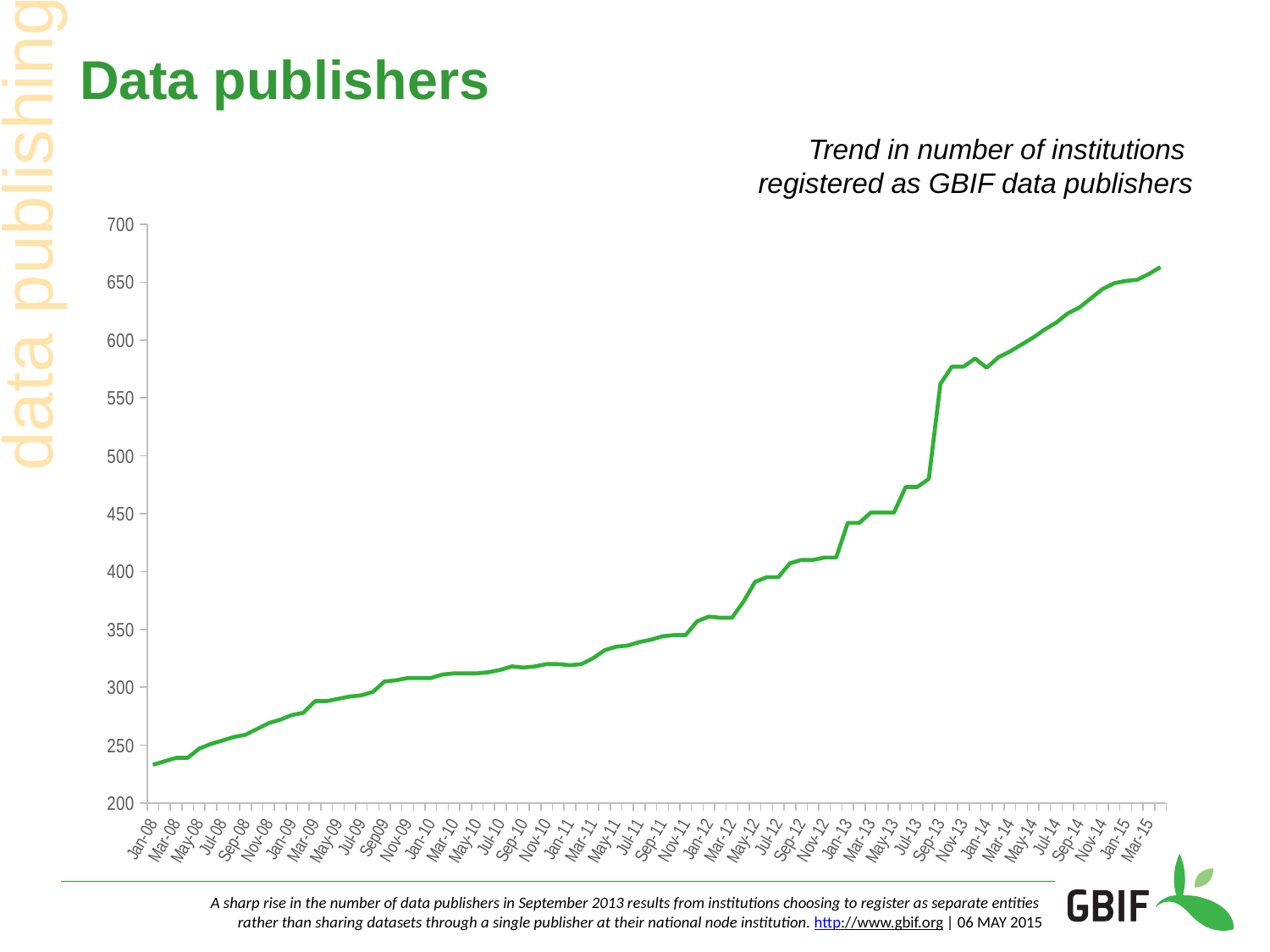
Is the value for Jan-08 greater or less than 250? less Is the value for Jan-14 greater or less than 550? greater What kind of chart is shown on the slide? line chart What colour is the line in the chart? green Is the value for Jan-13 greater or less than 400? greater Which point on the x axis has the lowest value? Jan-08 What is the title of the chart? Trend in number of institutions registered as GBIF data publishers Do the values rise or fall from Jan-08 to Mar-15? rise Which is larger, the value for Jan-13 or the value for Jan-12? Jan-13